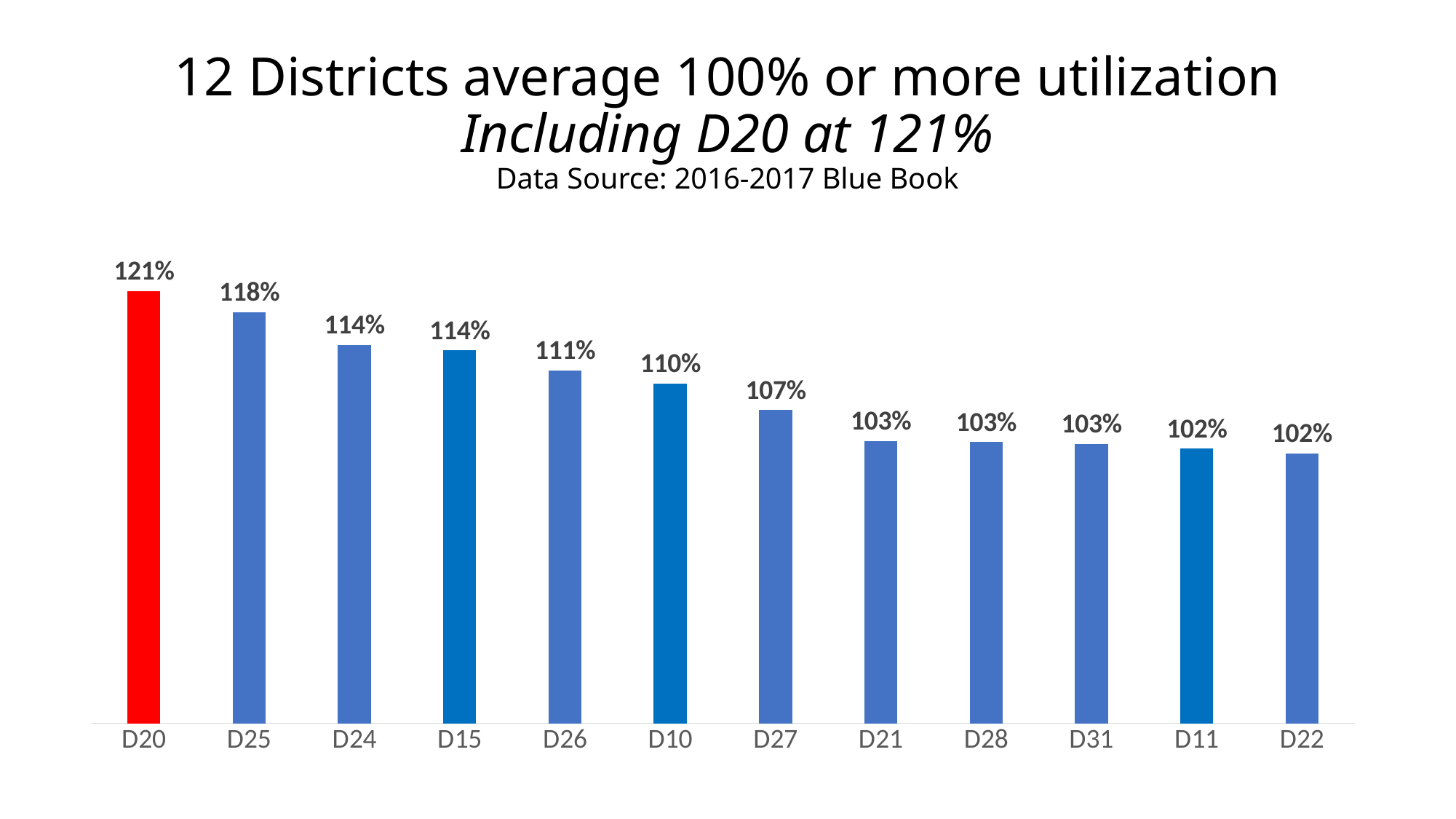
What kind of chart is shown on the slide? Bar chart Which has a higher utilization, D15 or D27? D15 Which district's bar is coloured red? D20 What is the utilization value for D10? 110% What is the difference between the utilization of D20 and D25? 3% Which district has the highest utilization? D20 Which has a higher utilization, D26 or D21? D26 What is the utilization value for D20? 121% How many districts are shown in the chart? 12 What is the difference between the utilization of D25 and D22? 16% Do the values rise or fall from left to right along the x axis? Fall What is the utilization value for D27? 107%